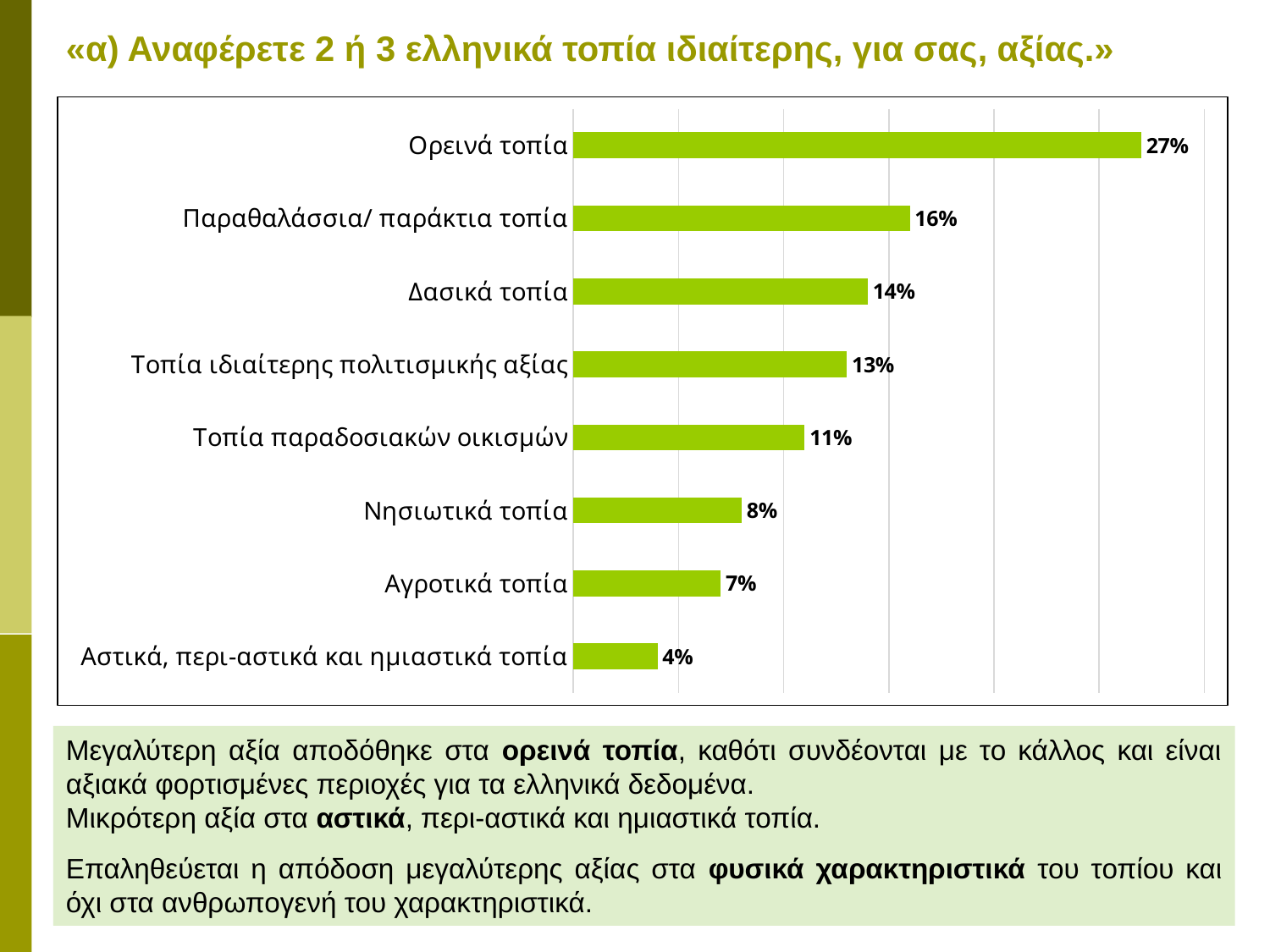
Which category has the highest value? Ορεινά τοπία What colour are the bars in the chart? Green What is the value for Ορεινά τοπία? 27% What is the value for Παραθαλάσσια/ παράκτια τοπία? 16% What is the difference between the values for Δασικά τοπία and Νησιωτικά τοπία? 6% Which category has the lowest value? Αστικά, περι-αστικά και ημιαστικά τοπία What is the value for Αγροτικά τοπία? 7% What kind of chart is shown on the slide? Bar chart What is the difference between the values for Ορεινά τοπία and Παραθαλάσσια/ παράκτια τοπία? 11% What is the value for Τοπία παραδοσιακών οικισμών? 11% Which is larger, the value for Δασικά τοπία or the value for Τοπία ιδιαίτερης πολιτισμικής αξίας? Δασικά τοπία How many categories are shown in the chart? 8